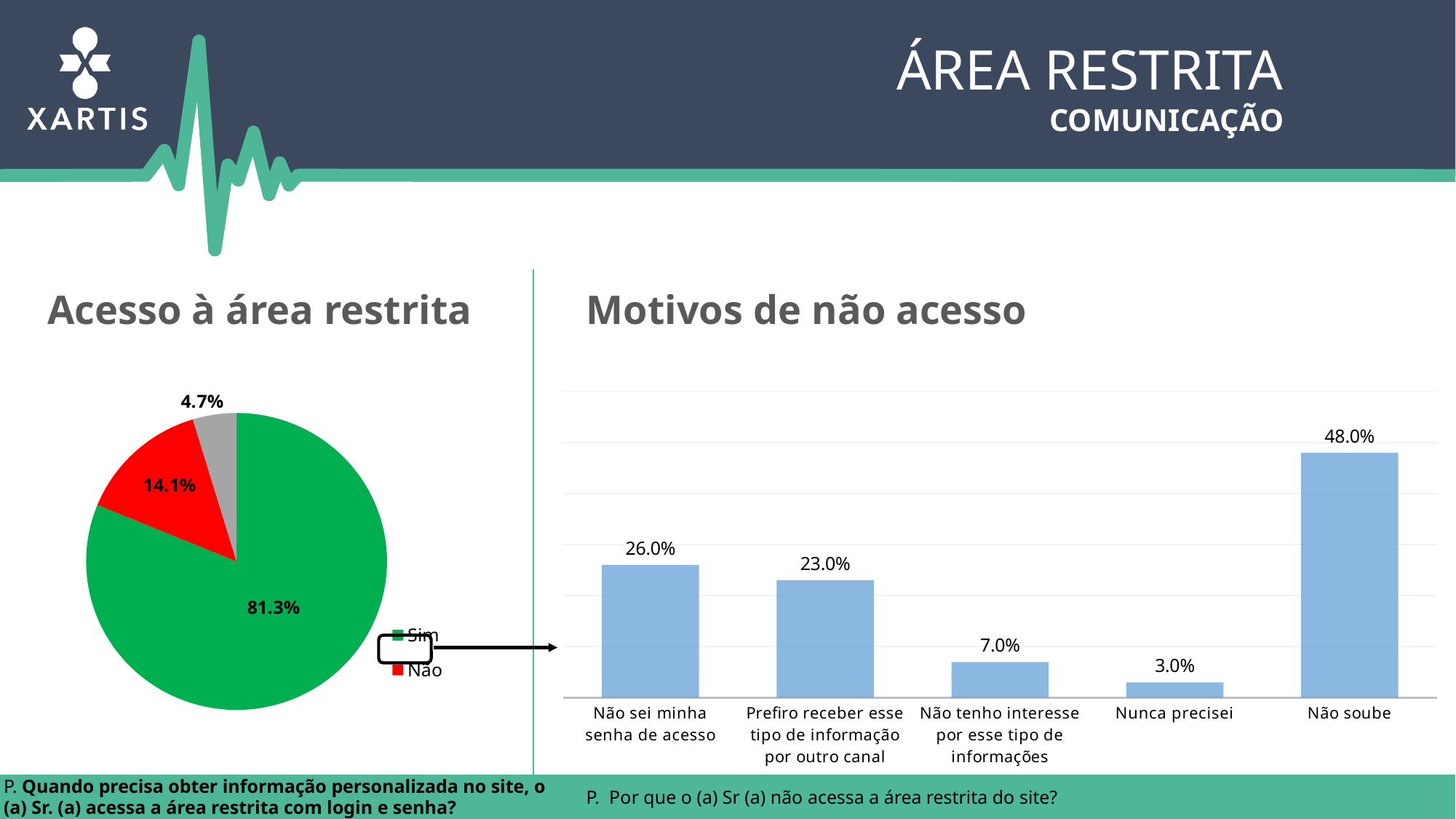
In the 'Acesso à área restrita' pie chart, what share does 'Sim' have? 81.3% In the 'Motivos de não acesso' chart, what is the value for 'Não soube'? 48.0% In the 'Motivos de não acesso' chart, which is larger: 'Não tenho interesse por esse tipo de informações' or 'Nunca precisei'? Não tenho interesse por esse tipo de informações In the 'Motivos de não acesso' chart, what is the difference between 'Não sei minha senha de acesso' and 'Prefiro receber esse tipo de informação por outro canal'? 3.0% What kind of chart is 'Motivos de não acesso'? Bar chart How many categories are shown in the 'Motivos de não acesso' chart? 5 In the 'Motivos de não acesso' chart, what is the value for 'Nunca precisei'? 3.0% What kind of chart is 'Acesso à área restrita'? Pie chart In the 'Acesso à área restrita' pie chart, what colour is the 'Sim' slice? Green In the 'Motivos de não acesso' chart, which category has the lowest value? Nunca precisei In the 'Motivos de não acesso' chart, which category has the highest value? Não soube In the 'Acesso à área restrita' pie chart, what share does 'Não' have? 14.1%